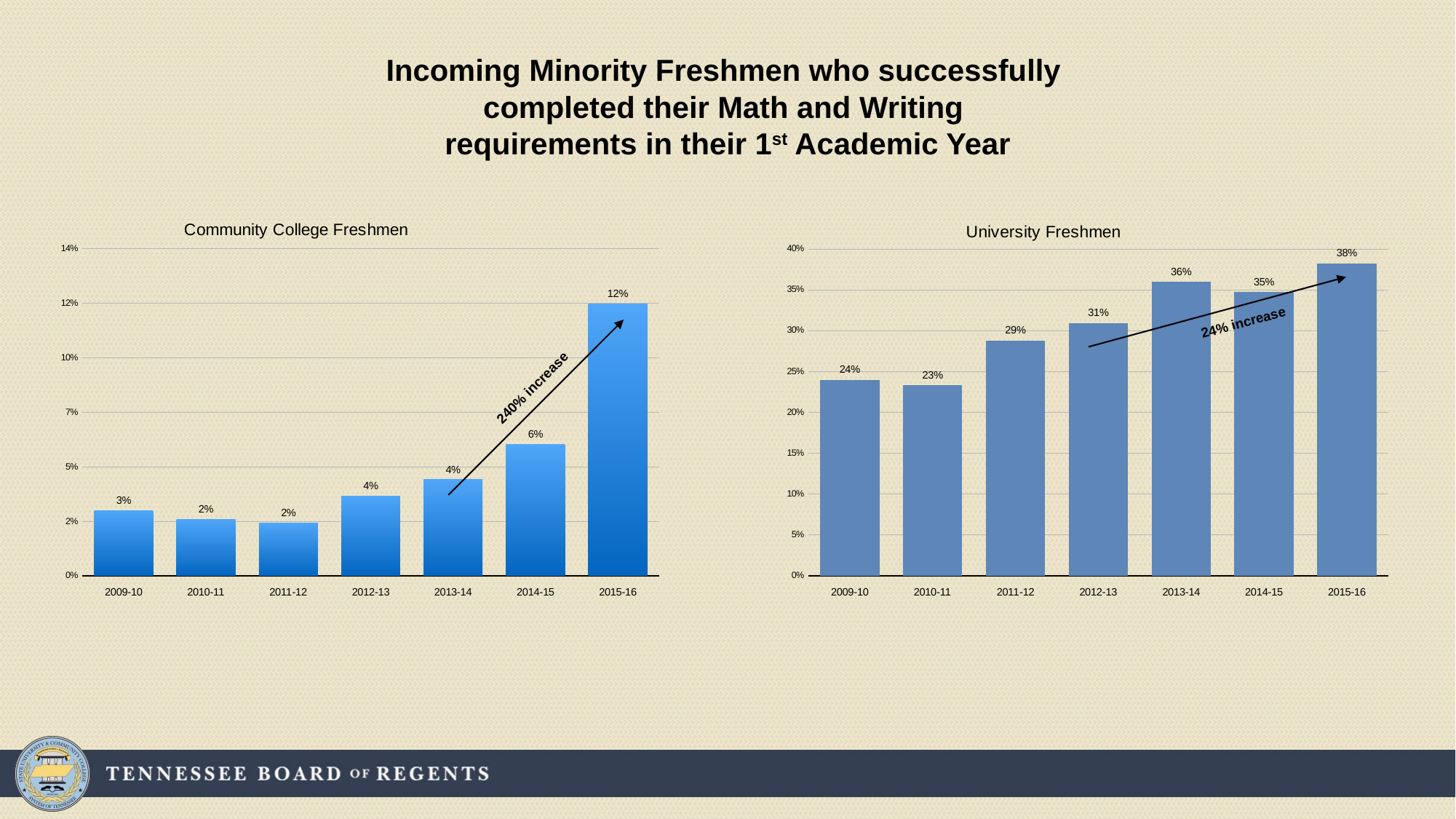
In the University Freshmen chart, which academic year has the lowest value? 2010-11 In the Community College Freshmen chart, which academic year has the highest value? 2015-16 What kind of chart is the University Freshmen chart? Bar chart In the University Freshmen chart, what is the value for 2011-12? 29% In the University Freshmen chart, what is the difference between the values for 2015-16 and 2009-10? 14% In the University Freshmen chart, which is larger, the value for 2013-14 or the value for 2014-15? 2013-14 How many academic years are shown in the Community College Freshmen chart? 7 In the Community College Freshmen chart, what is the difference between the values for 2015-16 and 2014-15? 6% In the Community College Freshmen chart, what is the value for 2015-16? 12% In the University Freshmen chart, which academic year has the highest value? 2015-16 In the University Freshmen chart, is the value for 2012-13 greater or less than 30%? greater What percentage increase is annotated with an arrow on the Community College Freshmen chart? 240% increase